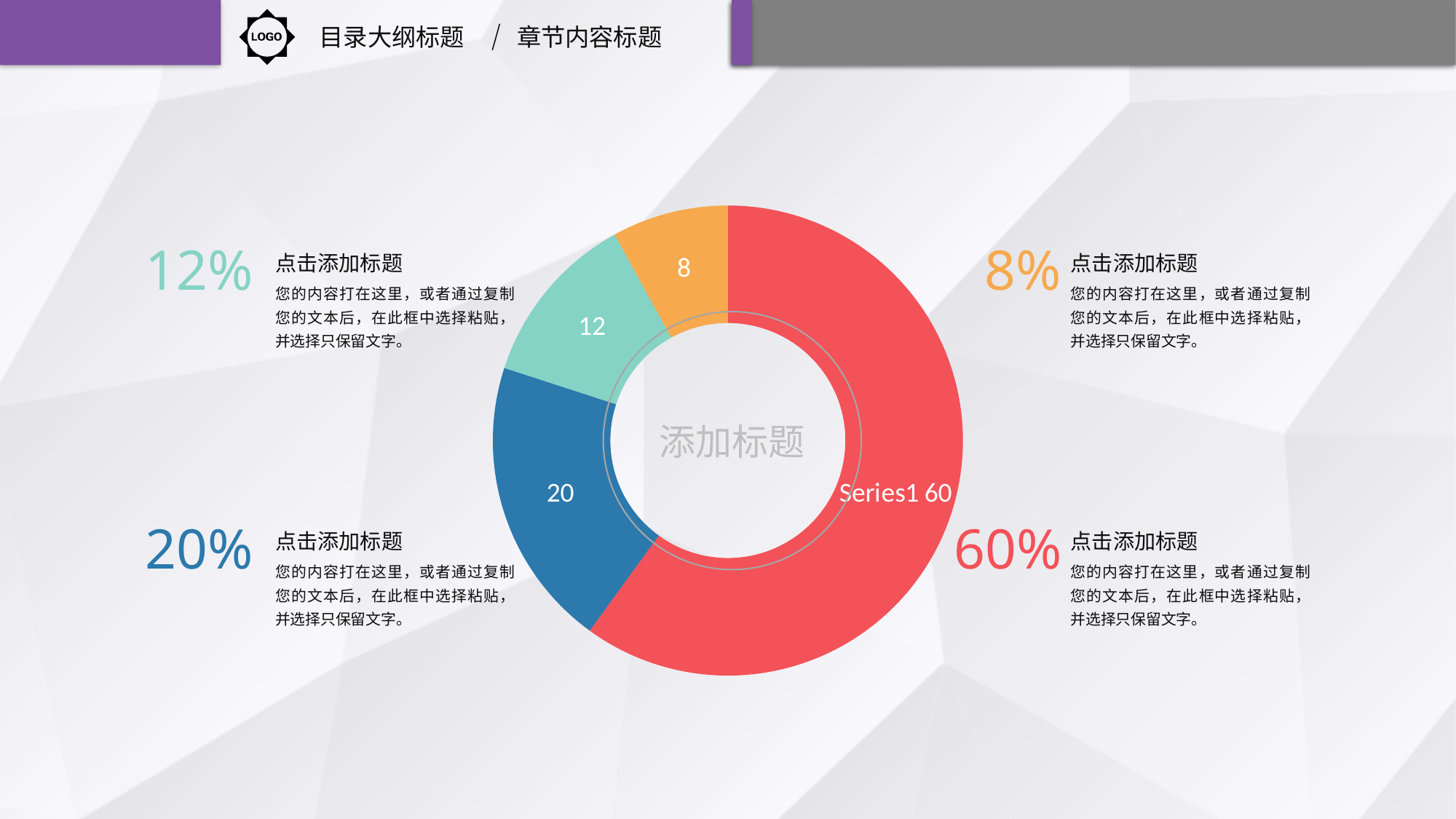
Which is larger, the teal slice or the orange slice? the teal slice What is the difference between the red slice's value and the blue slice's value? 40 Which slice of the doughnut chart has the smallest value? the orange slice (8) What value is printed on the red slice of the doughnut chart? 60 How many slices does the doughnut chart have? 4 What kind of chart is shown on the slide? doughnut chart Which slice of the doughnut chart has the largest value? the red slice (60) What series name is printed on the red slice of the doughnut chart? Series1 What value is printed on the teal slice of the doughnut chart? 12 What value is printed on the orange slice of the doughnut chart? 8 What share of the doughnut chart does the blue slice represent? 20% What value is printed on the blue slice of the doughnut chart? 20